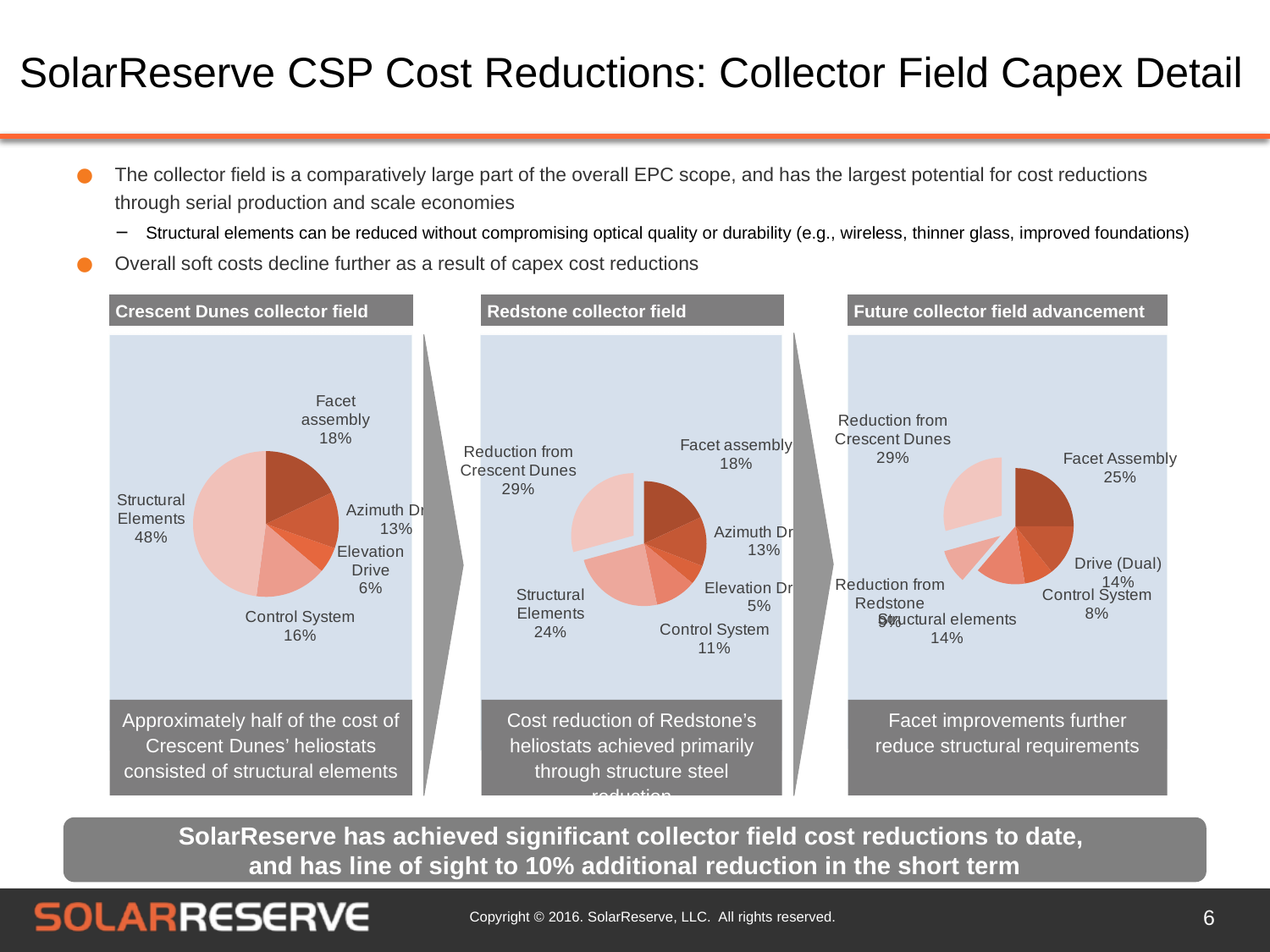
In the Future collector field advancement chart, what share is Facet Assembly? 25% What type of chart is used in the Crescent Dunes collector field panel? Pie chart In the Redstone collector field chart, how many slices does the pie have? 6 In the Crescent Dunes collector field chart, what is the difference between Structural Elements and Control System? 32% In the Redstone collector field chart, what share is Reduction from Crescent Dunes? 29% In the Future collector field advancement chart, what share is Control System? 8% In the Crescent Dunes collector field chart, which category has the smallest share? Elevation Drive In the Crescent Dunes collector field chart, what share is Structural Elements? 48% In the Crescent Dunes collector field chart, which category has the largest share? Structural Elements In the Crescent Dunes collector field chart, how many slices does the pie have? 5 In the Redstone collector field chart, what share is Structural Elements? 24% In the Redstone collector field chart, which is larger, Control System or Azimuth Dr? Azimuth Dr